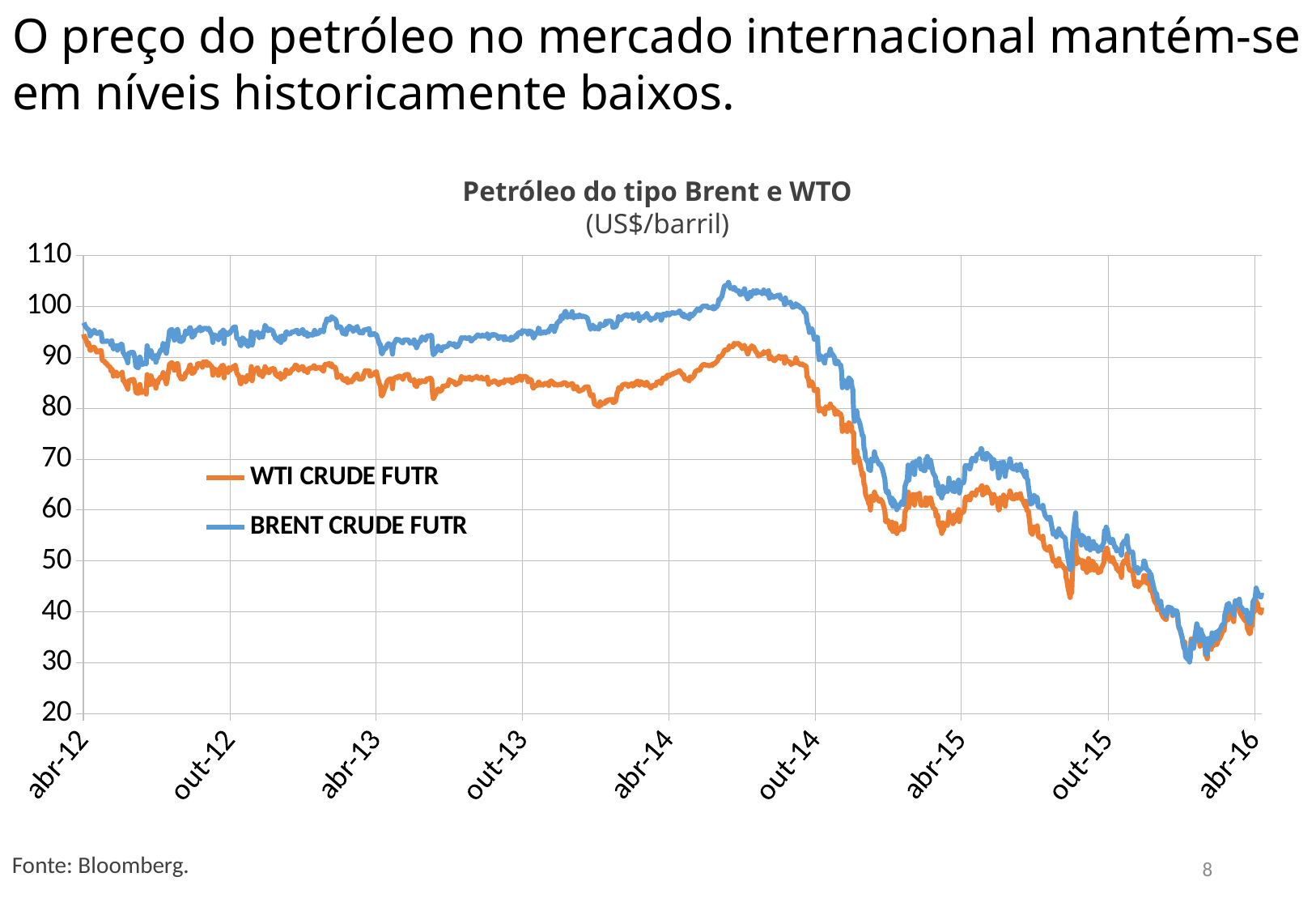
Is the value for BRENT CRUDE FUTR at abr-12 greater or less than 90? greater What unit is the chart measured in, according to the subtitle? US$/barril Which series reaches the highest value on the chart? BRENT CRUDE FUTR Is the value for WTI CRUDE FUTR at out-15 greater or less than 60? less Is the value for BRENT CRUDE FUTR at abr-16 greater or less than 40? greater What is the title of the chart? Petróleo do tipo Brent e WTO What kind of chart is shown on the slide? line chart Do the oil prices rise or fall overall from abr-12 to abr-16? fall Which series is higher at out-13, WTI CRUDE FUTR or BRENT CRUDE FUTR? BRENT CRUDE FUTR How many series does the legend list? 2